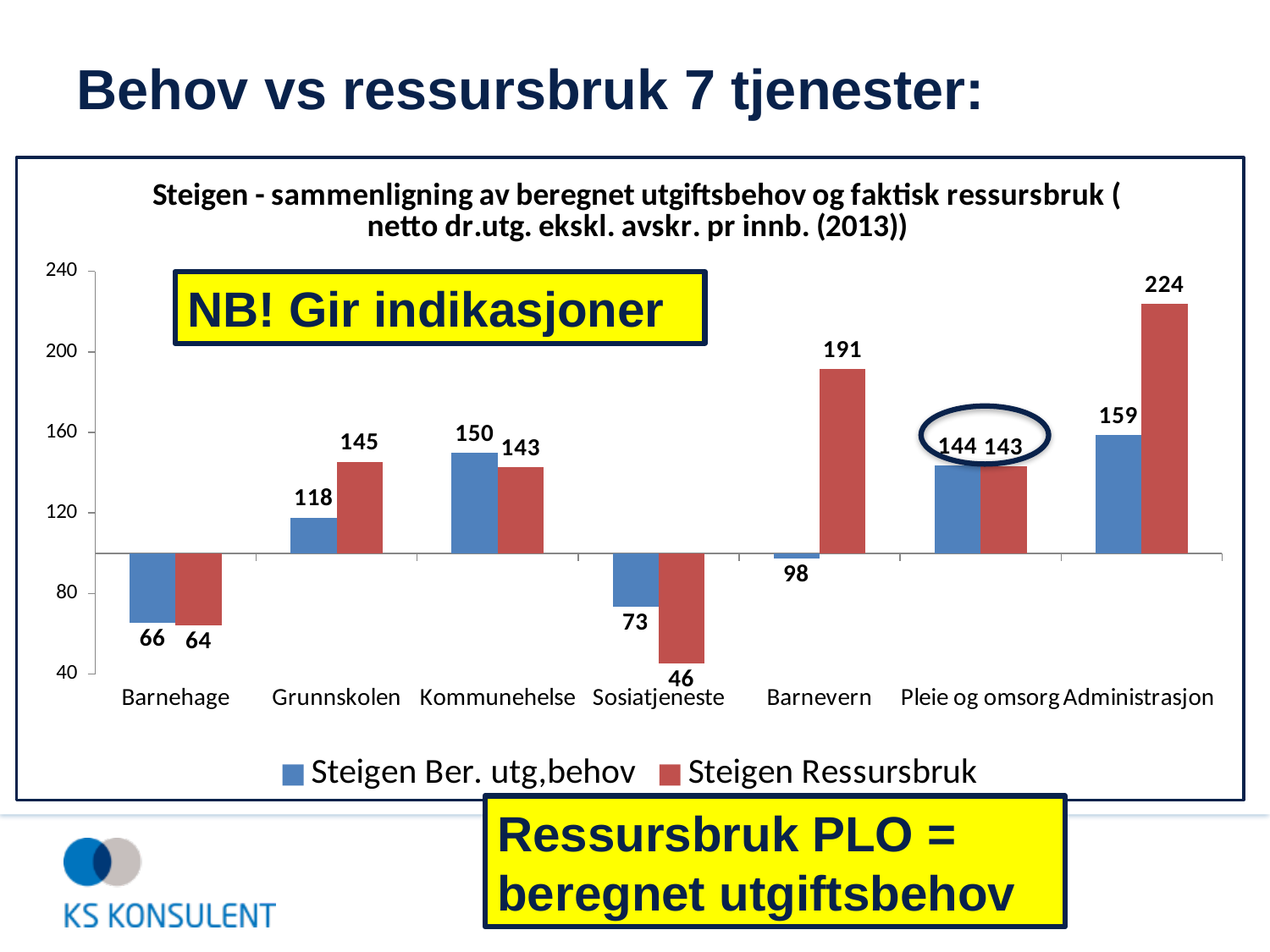
What is the Steigen Ressursbruk value for Administrasjon? 224 How many categories are shown on the x axis? 7 Which category has the lowest Steigen Ressursbruk value? Sosiatjeneste What kind of chart is shown on the slide? Bar chart What is the difference between Steigen Ressursbruk and Steigen Ber. utg,behov for Barnevern? 93 What is the Steigen Ressursbruk value for Barnevern? 191 What is the Steigen Ber. utg,behov value for Kommunehelse? 150 For Grunnskolen, which is larger: Steigen Ber. utg,behov or Steigen Ressursbruk? Steigen Ressursbruk What is the difference between Steigen Ressursbruk and Steigen Ber. utg,behov for Administrasjon? 65 How many series does the legend list? 2 Which category has the highest Steigen Ressursbruk value? Administrasjon Which category has the lowest Steigen Ber. utg,behov value? Barnehage